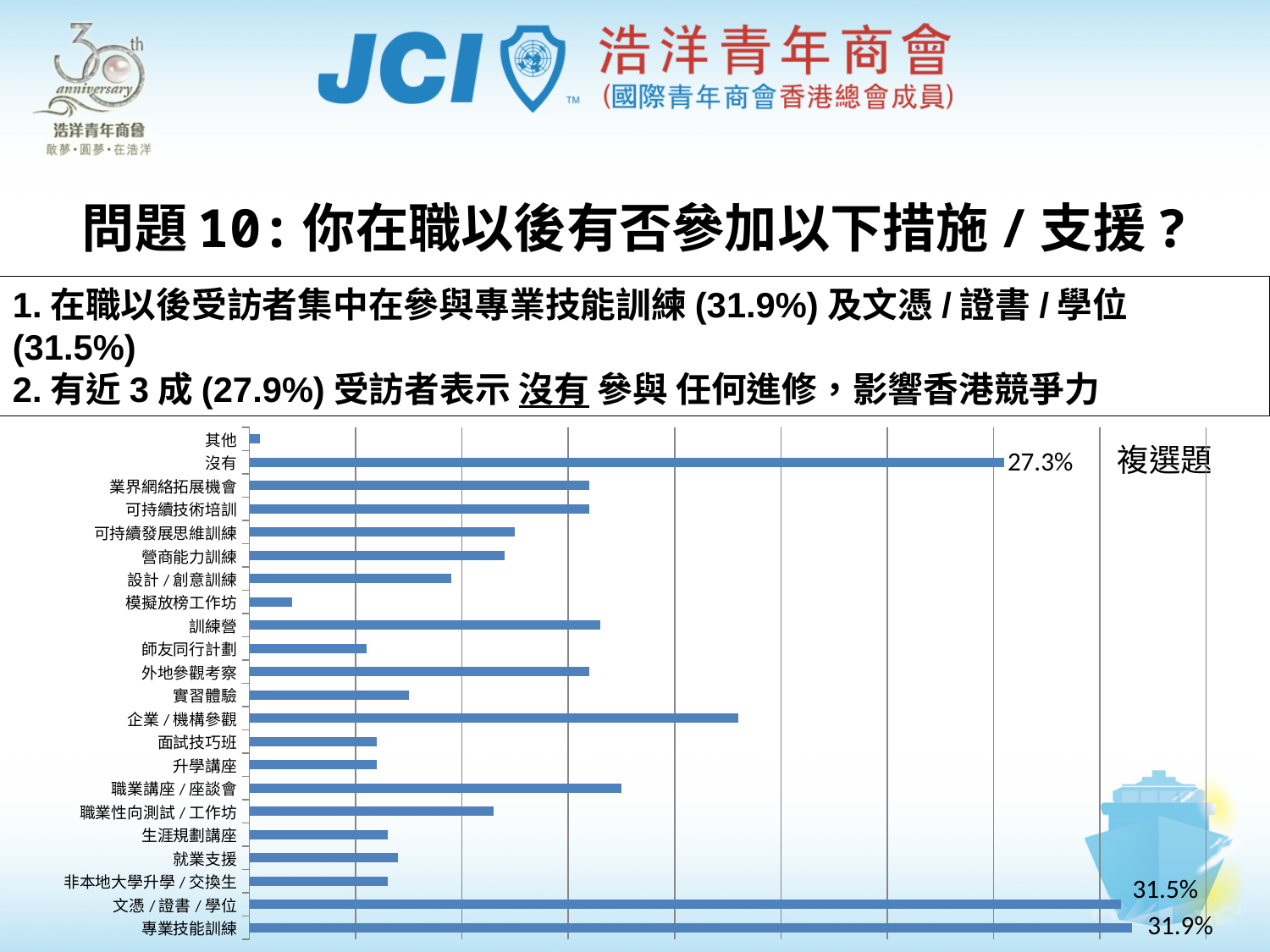
How many categories are shown in the chart? 22 Which category has the lowest value in the chart? 其他 What is the value shown for 專業技能訓練? 31.9% What is the difference between the values for 專業技能訓練 and 文憑 / 證書 / 學位? 0.4 percentage points What type of chart is shown on the slide? bar chart What is the value shown for 沒有? 27.3% Which has a larger value, 訓練營 or 模擬放榜工作坊? 訓練營 Which has a larger value, 企業 / 機構參觀 or 實習體驗? 企業 / 機構參觀 What is the value shown for 文憑 / 證書 / 學位? 31.5% Which category has the highest value in the chart? 專業技能訓練 What is the difference between the values for 專業技能訓練 and 沒有? 4.6 percentage points What note is printed in the upper right of the chart area indicating the question type? 複選題